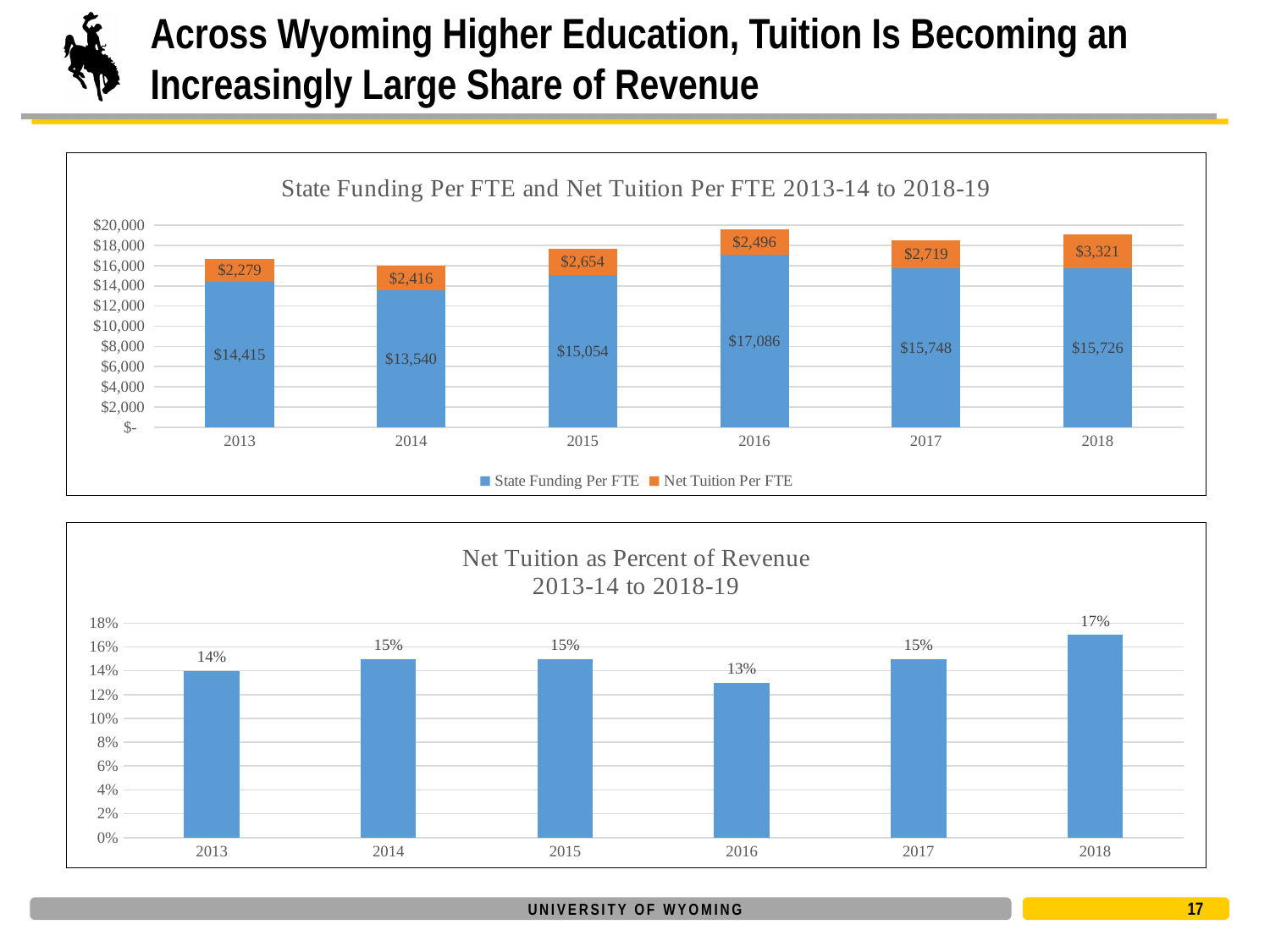
In the bottom chart, which year has the lowest Net Tuition as Percent of Revenue? 2016 How many years are shown on the x axis of the bottom chart? 6 In the bottom chart, what is the Net Tuition as Percent of Revenue for 2016? 13% How many series does the legend of the top chart list? 2 In the top chart, what is the State Funding Per FTE value for 2016? $17,086 In the top chart, what is the difference between Net Tuition Per FTE in 2018 and in 2017? $602 In the top chart, which year has the lowest Net Tuition Per FTE? 2013 In the bottom chart, which year has the highest Net Tuition as Percent of Revenue? 2018 In the top chart, what is the Net Tuition Per FTE value for 2018? $3,321 In the top chart, which year has the highest State Funding Per FTE? 2016 In the top chart, what is the total of the stacked bar for 2016? $19,582 What kind of chart is the bottom chart? Bar chart